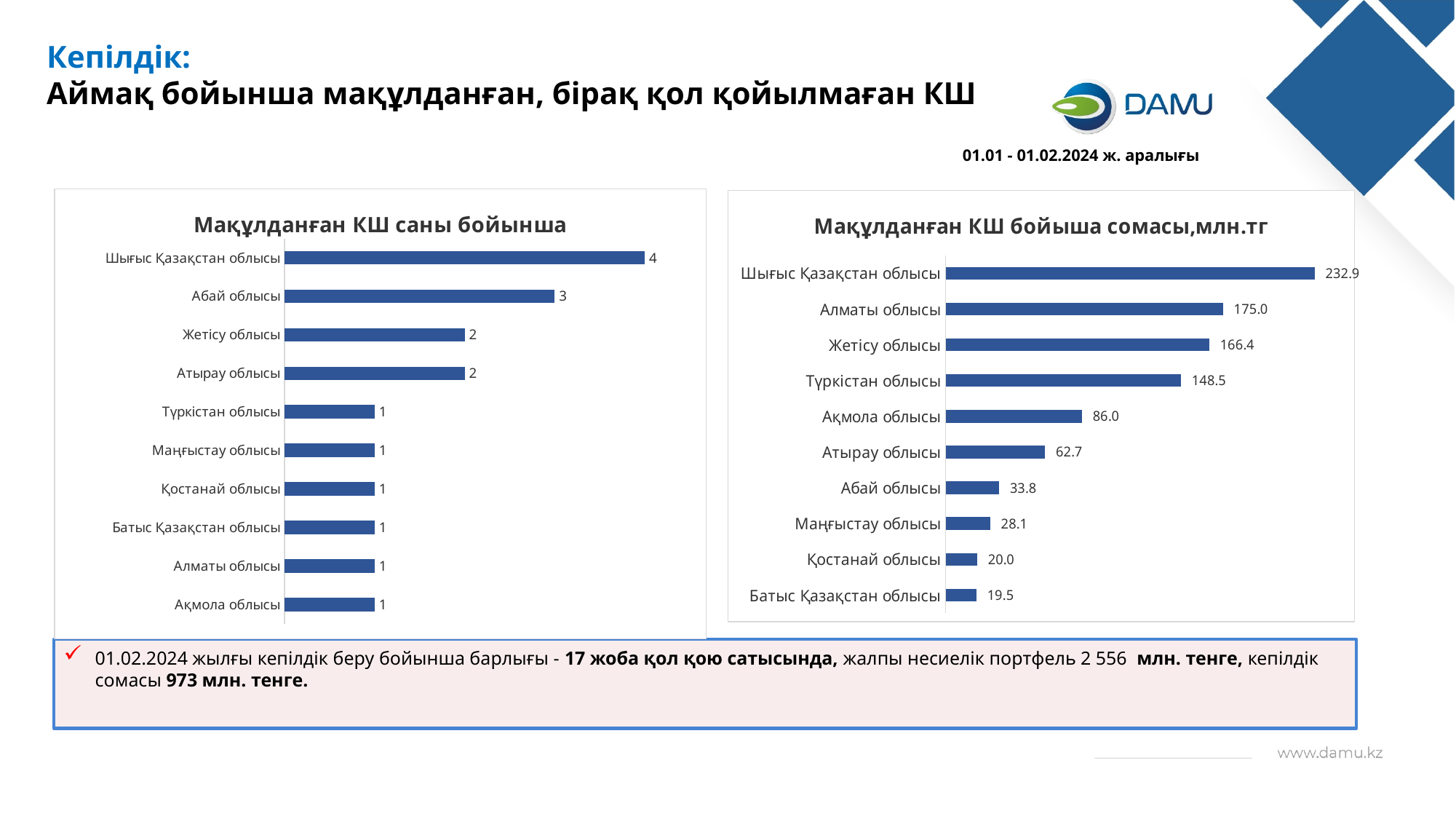
In the chart 'Мақұлданған КШ бойыша сомасы,млн.тг', what is the value for Түркістан облысы? 148.5 In the chart 'Мақұлданған КШ бойыша сомасы,млн.тг', what is the value for Ақмола облысы? 86.0 In the chart 'Мақұлданған КШ бойыша сомасы,млн.тг', which is larger: Алматы облысы or Жетісу облысы? Алматы облысы In the chart 'Мақұлданған КШ бойыша сомасы,млн.тг', which region has the lowest value? Батыс Қазақстан облысы In the chart 'Мақұлданған КШ бойыша сомасы,млн.тг', what is the difference between Шығыс Қазақстан облысы and Алматы облысы? 57.9 In the chart 'Мақұлданған КШ саны бойынша', which region has the highest value? Шығыс Қазақстан облысы In the chart 'Мақұлданған КШ саны бойынша', what is the value for Абай облысы? 3 In the chart 'Мақұлданған КШ саны бойынша', how many regions are shown? 10 What is the title of the chart on the left side of the slide? Мақұлданған КШ саны бойынша What type of chart is 'Мақұлданған КШ бойыша сомасы,млн.тг'? Bar chart In the chart 'Мақұлданған КШ саны бойынша', what is the difference between Шығыс Қазақстан облысы and Жетісу облысы? 2 In the chart 'Мақұлданған КШ саны бойынша', what is the value for Шығыс Қазақстан облысы? 4